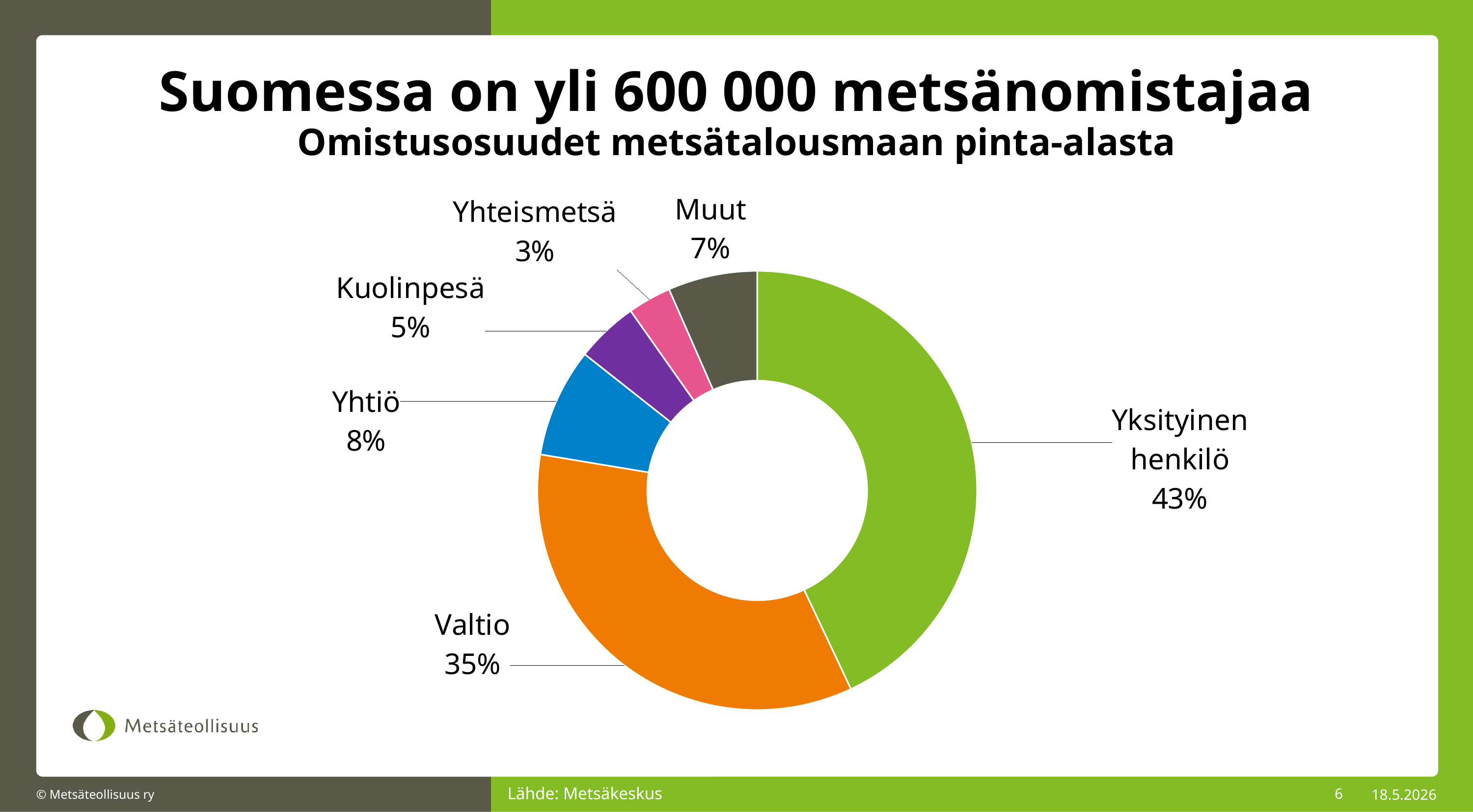
Which owner category has the largest share of forestry land? Yksityinen henkilö How many owner categories are shown in the chart? 6 Which has a larger share, Yhtiö or Muut? Yhtiö Which owner category has the smallest share of forestry land? Yhteismetsä What share of forestry land is owned by Valtio? 35% What share of forestry land is owned by Yhtiö? 8% What is the difference in percentage points between the shares of Yksityinen henkilö and Valtio? 8 What share of forestry land is owned by Kuolinpesä? 5% What share of forestry land is owned by Yhteismetsä? 3% What share of forestry land is owned by Yksityinen henkilö? 43% What kind of chart is shown on the slide? Pie (doughnut) chart What share of forestry land is owned by Muut? 7%